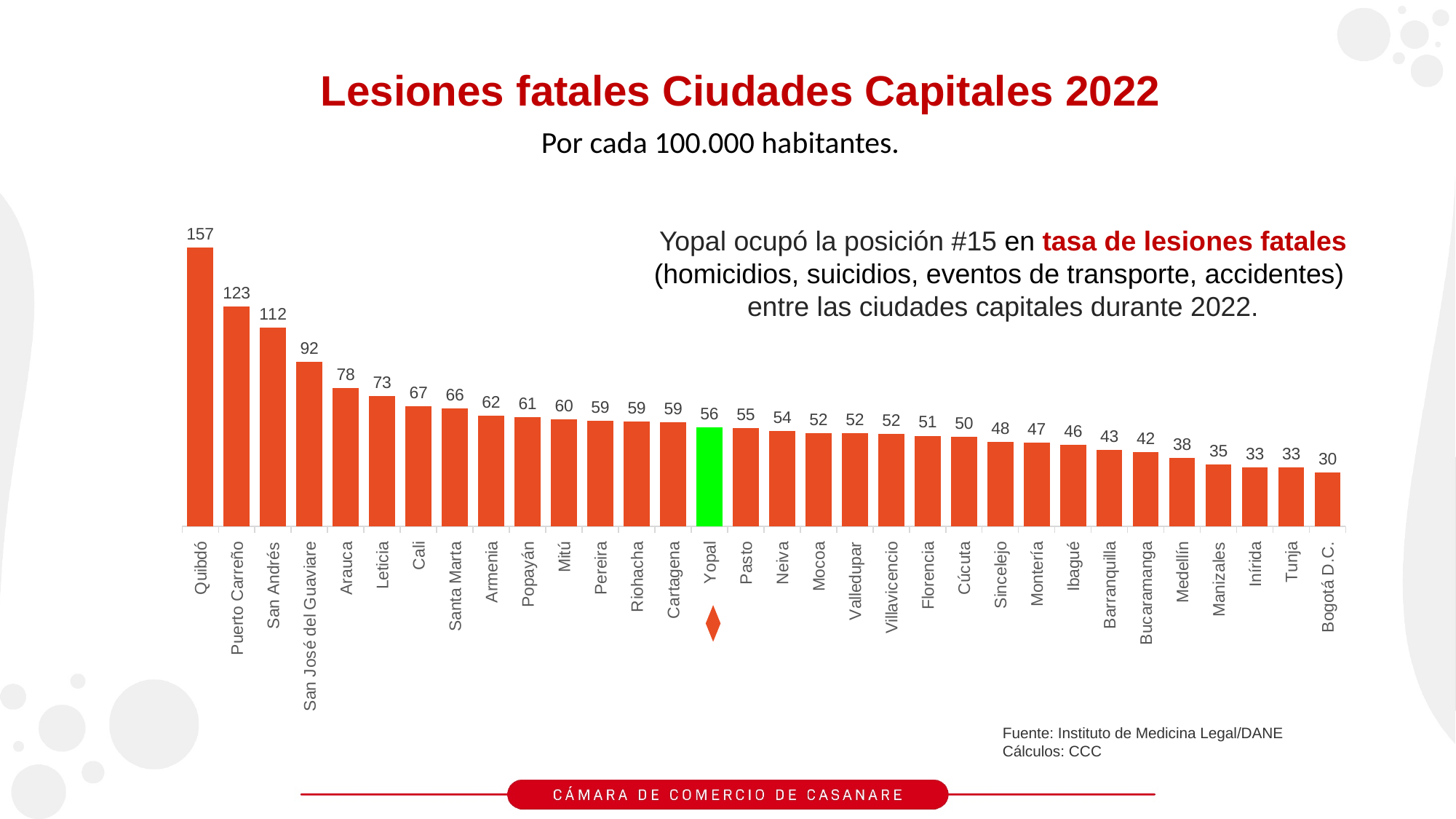
What kind of chart is shown on the slide? Bar chart Which has a larger value, Cali or Medellín? Cali Which bar is coloured green instead of orange? Yopal Which city has the highest value? Quibdó How many cities are shown in the chart? 32 What is the value for Yopal? 56 Which city has the lowest value? Bogotá D.C. What is the value for Bogotá D.C.? 30 Do the values rise or fall from left to right along the x axis? Fall What is the difference between the values for Quibdó and Puerto Carreño? 34 What is the difference between the values for Yopal and Bogotá D.C.? 26 What is the value for San José del Guaviare? 92